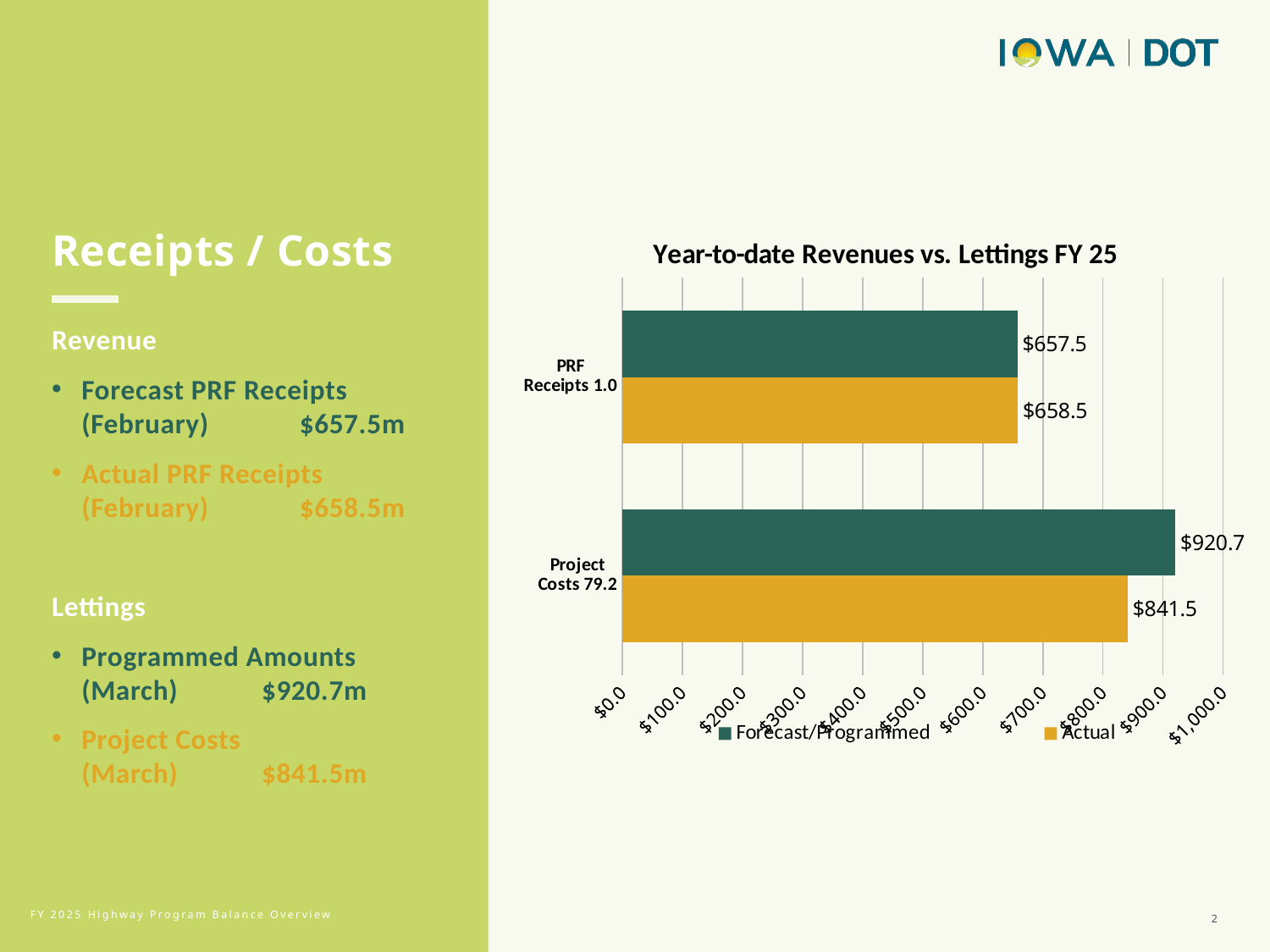
Which series is shown in yellow on the chart? Actual What is the difference between the Forecast/Programmed and Actual values for Project Costs? $79.2 Which bar has the highest value on the chart? Forecast/Programmed for Project Costs What is the Forecast/Programmed value for PRF Receipts? $657.5 What kind of chart is shown on the slide? bar chart Is the Actual value for Project Costs greater or less than $800.0? greater How many series does the chart legend list? 2 What is the Actual value for PRF Receipts? $658.5 What is the Actual value for Project Costs? $841.5 What is the title of the chart? Year-to-date Revenues vs. Lettings FY 25 What is the Forecast/Programmed value for Project Costs? $920.7 How many categories are shown on the chart? 2